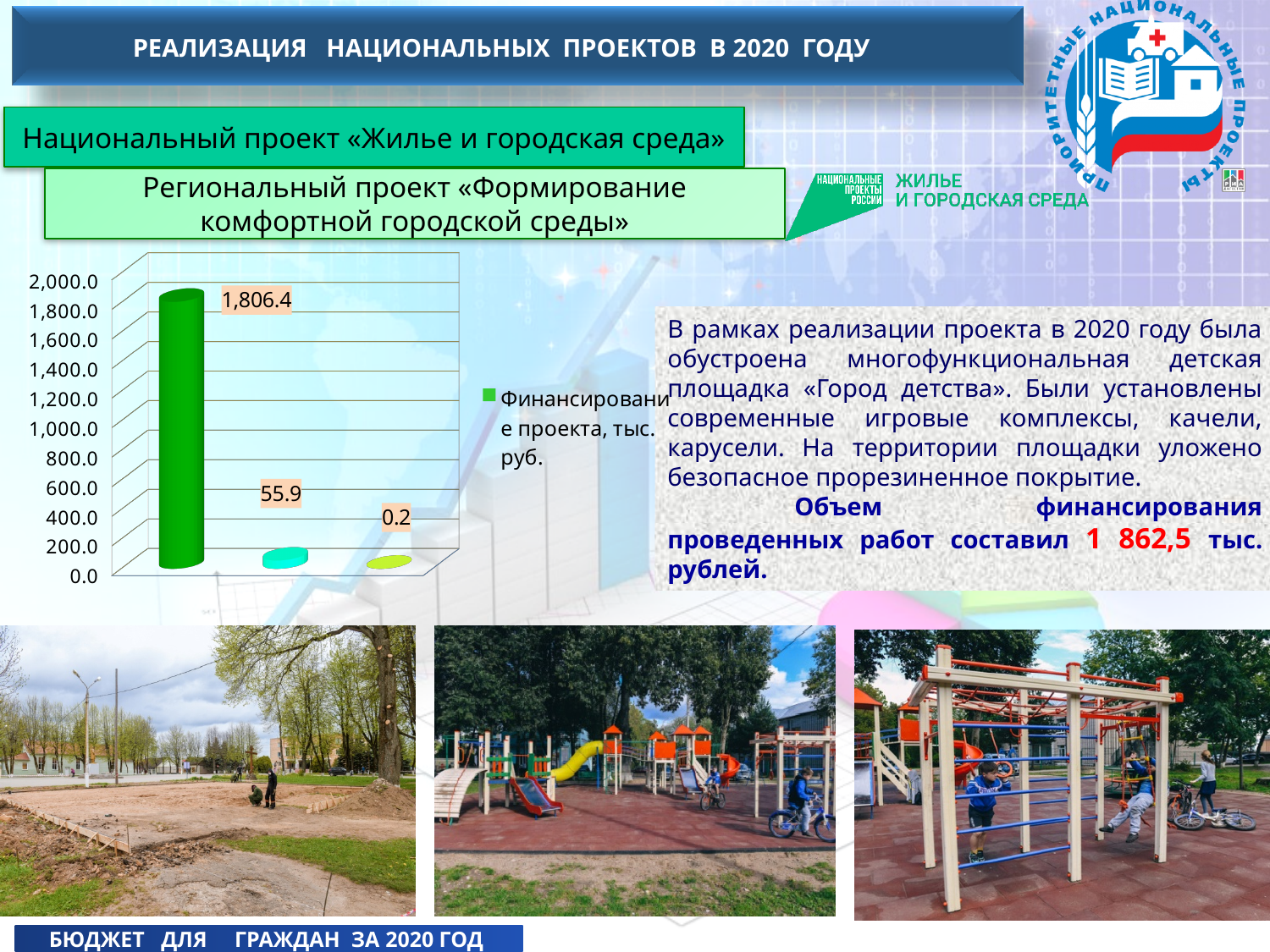
Do the bar values rise or fall from left to right across the chart? fall Is the value of the tallest bar greater or less than 1,600.0? greater What is the difference between the first bar (1,806.4) and the second bar (55.9)? 1,750.5 What is the value shown on the middle (cyan) bar in the chart? 55.9 What is the value shown on the tallest (green) bar in the chart? 1,806.4 What type of chart is shown on the slide? bar chart What is the lowest value plotted in the chart? 0.2 What is the legend entry of the chart? Финансирование проекта, тыс. руб. What is the highest value plotted in the chart? 1,806.4 How many series does the chart legend list? 1 What is the value shown on the third (light green) bar in the chart? 0.2 How many bars are plotted in the chart? 3